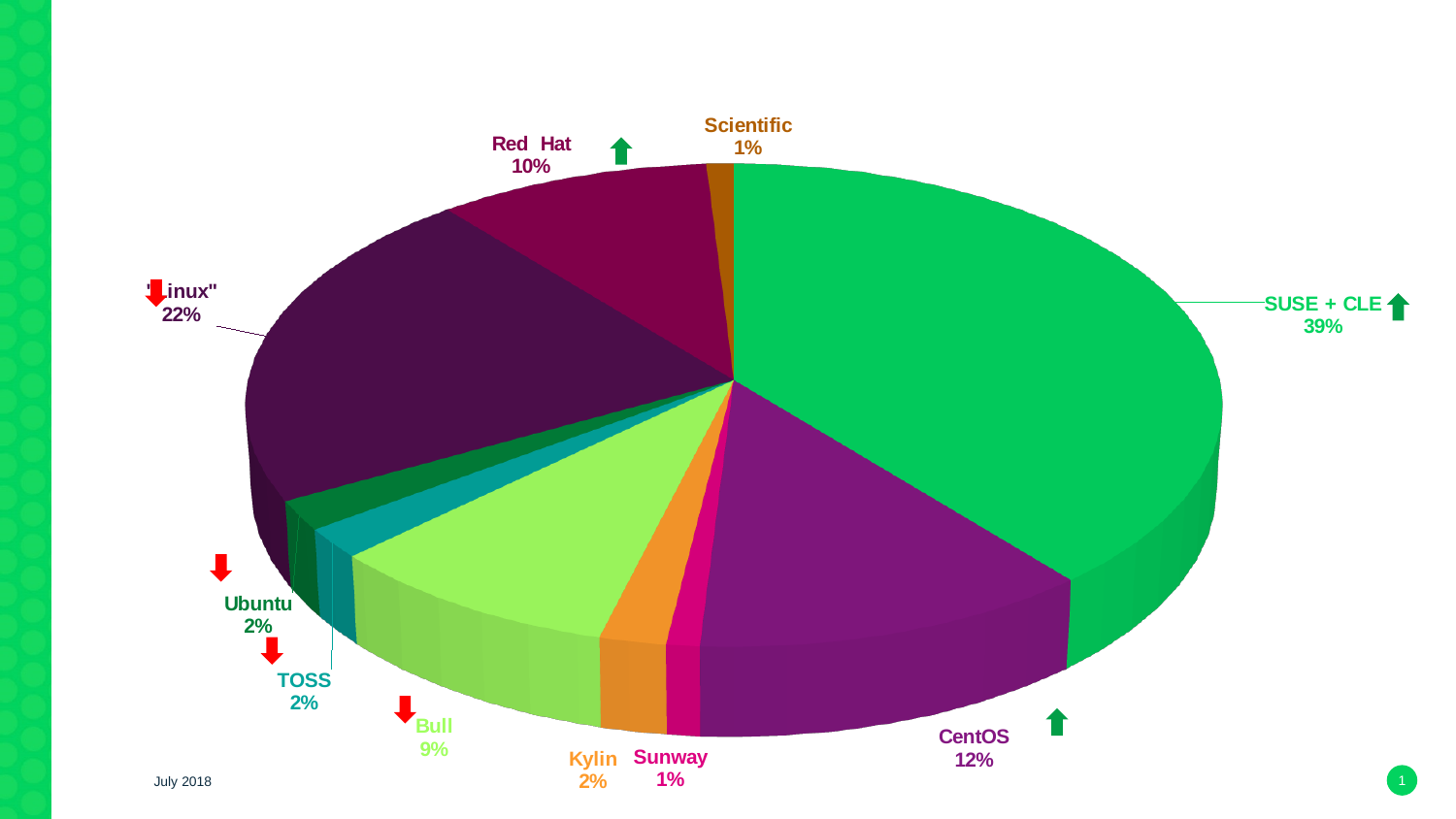
What date is printed at the bottom left of the slide? July 2018 What is the value shown for "Linux"? 22% What is the difference between the SUSE + CLE share and the "Linux" share? 17% What is the value shown for CentOS? 12% What kind of chart is shown on the slide? pie chart Which category has the largest slice of the pie? SUSE + CLE What is the value shown for Red Hat? 10% What is the value shown for Bull? 9% What is the combined share of Ubuntu and TOSS? 4% Which is larger, the share for CentOS or the share for Red Hat? CentOS What is the value shown for Kylin? 2% What share of the pie does SUSE + CLE hold? 39%